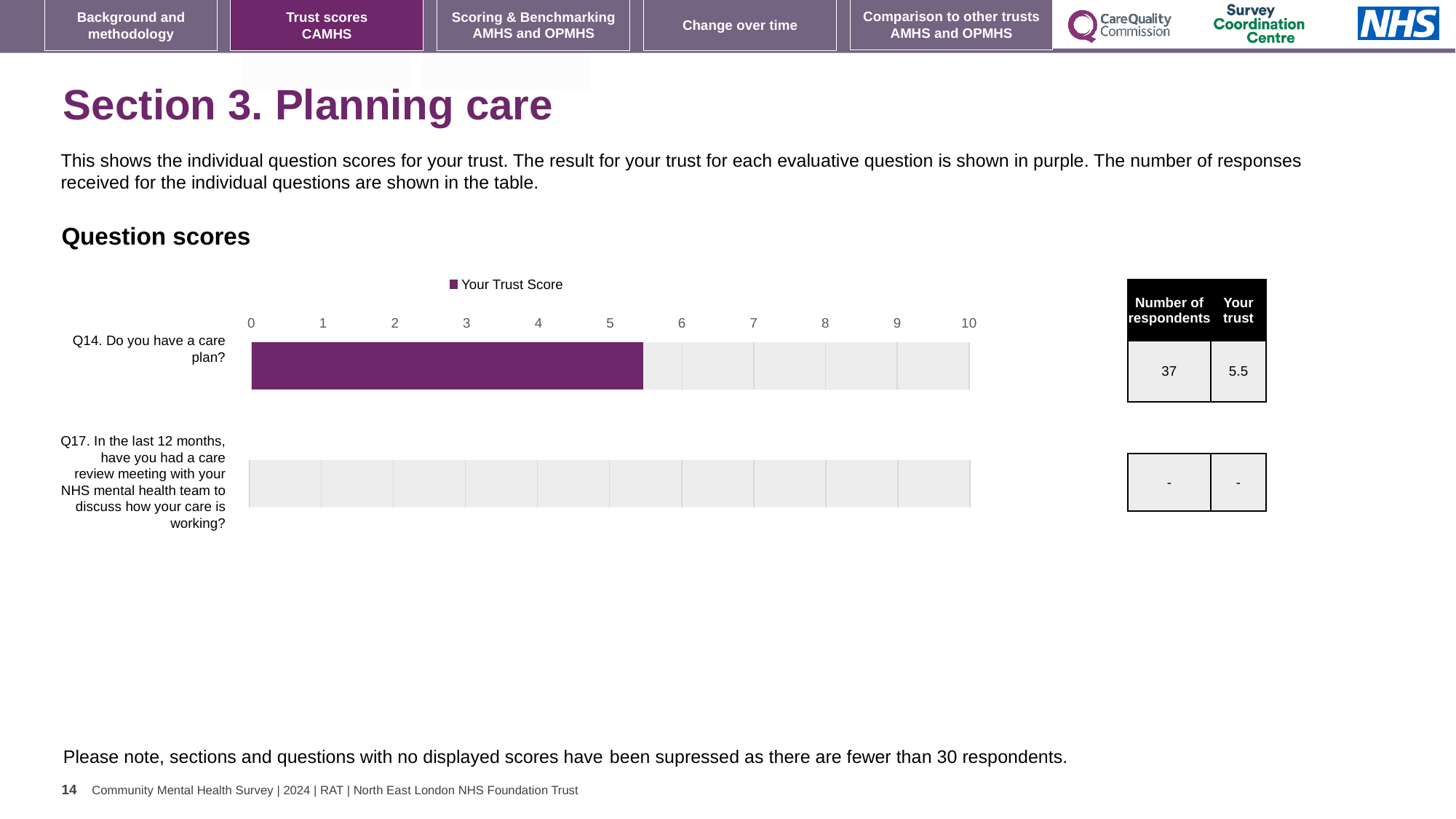
What is the name of the series shown in the chart legend? Your Trust Score What is the trust score for Q14 'Do you have a care plan?'? 5.5 What is the maximum value shown on the chart's horizontal axis? 10 How many respondents answered Q14 according to the table next to the chart? 37 Is the trust score for Q14 'Do you have a care plan?' greater or less than 6? less Is the trust score for Q14 'Do you have a care plan?' greater or less than 5? greater How many series does the chart legend list? 1 What kind of chart is shown under 'Question scores'? bar chart How many questions (categories) are listed on the chart's vertical axis? 2 Does the chart display a bar for Q17 about a care review meeting in the last 12 months? No Which question has the highest plotted trust score on the chart? Q14. Do you have a care plan?